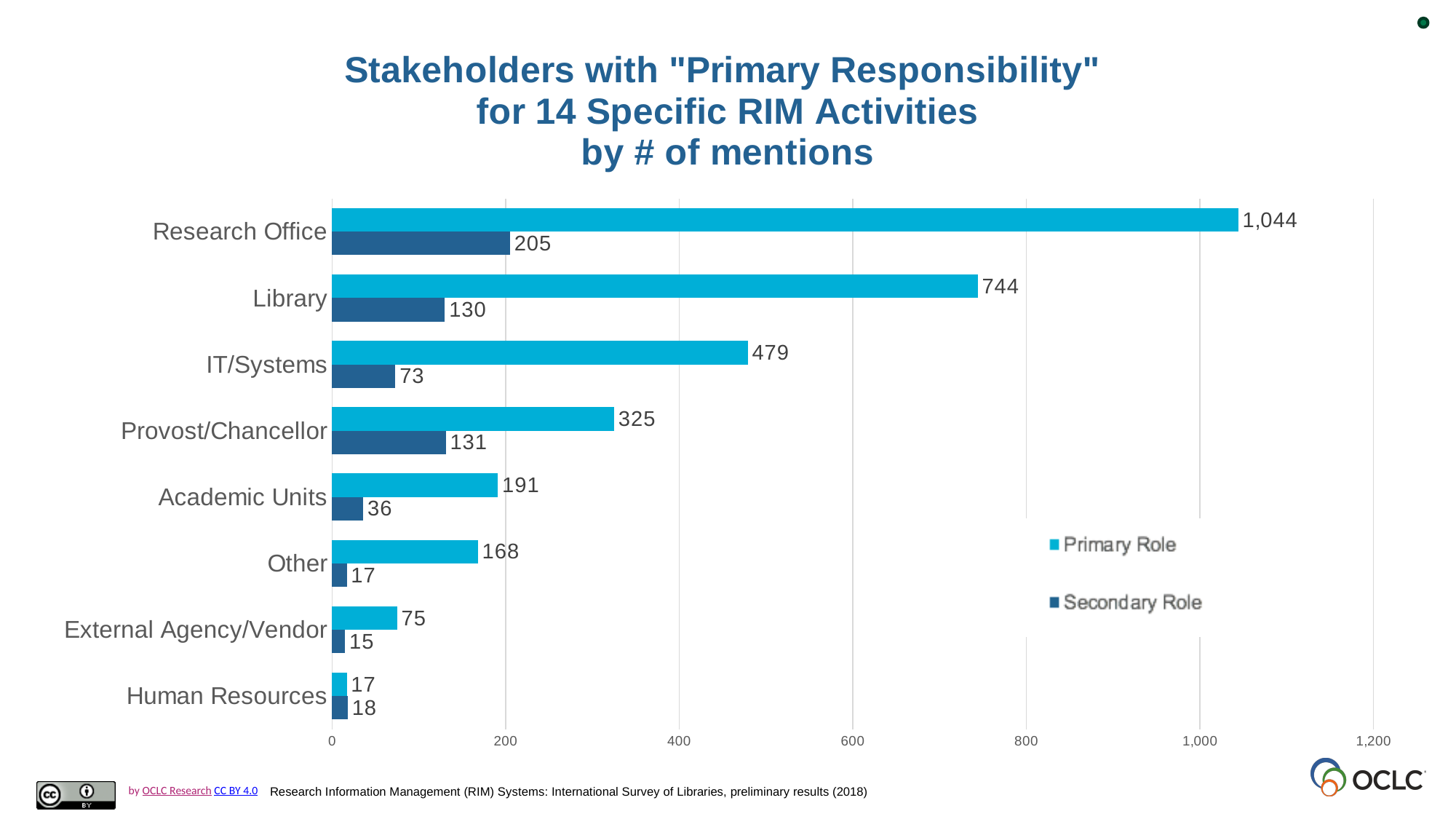
What is the difference between the Primary Role values for Library and IT/Systems? 265 What are the two series named in the legend? Primary Role and Secondary Role Is the Primary Role value for IT/Systems greater or less than 400? greater What is the Secondary Role value for Library? 130 What kind of chart is shown on the slide? Bar chart How many series does the legend list? 2 What is the Primary Role value for Research Office? 1,044 Which is larger: the Secondary Role value for Provost/Chancellor or for Library? Provost/Chancellor Which category has the highest Primary Role value? Research Office How many stakeholder categories are shown on the chart? 8 What is the Primary Role value for Provost/Chancellor? 325 Which category has the lowest Secondary Role value? External Agency/Vendor